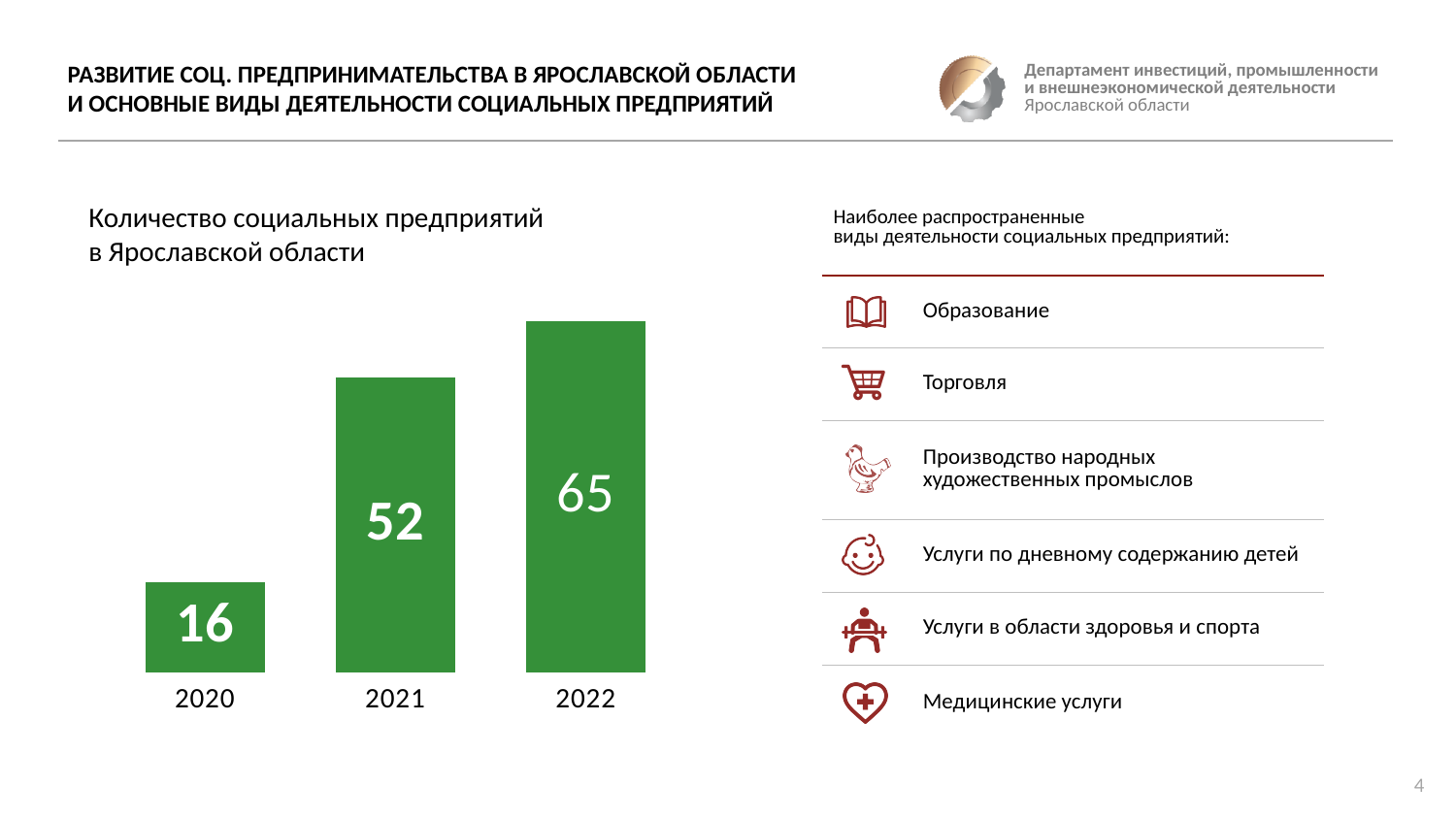
What is the number of social enterprises in the Yaroslavl region in 2021? 52 Which year has the highest number of social enterprises? 2022 How many years are shown on the chart? 3 By how much did the number of social enterprises increase from 2020 to 2021? 36 What type of chart is used to show the number of social enterprises? Bar chart Which year has the lowest number of social enterprises? 2020 What is the number of social enterprises in the Yaroslavl region in 2022? 65 Which is larger, the value for 2021 or the value for 2022? 2022 What colour are the bars in the chart? Green What is the difference between the 2022 and 2021 values? 13 Do the values rise or fall from 2020 to 2022? Rise What is the number of social enterprises in the Yaroslavl region in 2020? 16